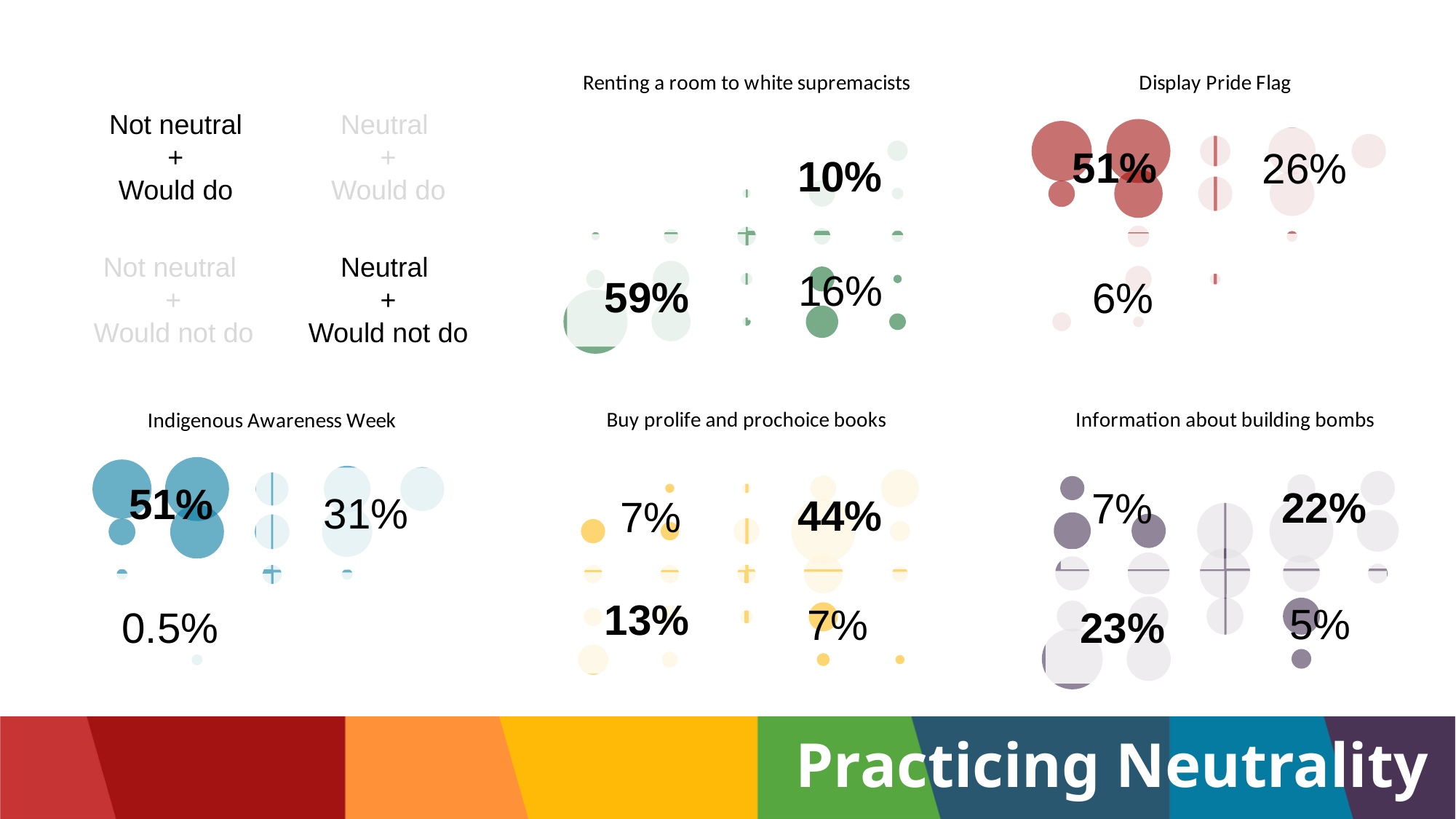
In the 'Display Pride Flag' chart, what is the difference between the 'Not neutral + Would do' and 'Neutral + Would do' percentages? 25% In the 'Buy prolife and prochoice books' chart, which quadrant has the highest percentage? Neutral + Would do In the 'Indigenous Awareness Week' chart, what percentage is shown for 'Not neutral + Would not do'? 0.5% In the 'Renting a room to white supremacists' chart, which is larger: 'Neutral + Would not do' or 'Neutral + Would do'? Neutral + Would not do How many bubble charts are shown on the slide? 5 In the 'Information about building bombs' chart, what is the difference between 'Not neutral + Would not do' and 'Neutral + Would do'? 1% In the 'Information about building bombs' chart, which quadrant has the lowest percentage? Neutral + Would not do In the 'Renting a room to white supremacists' chart, what percentage is shown for 'Neutral + Would do'? 10% What kind of chart is used to show the survey results on this slide? Bubble chart According to the legend, which quadrant position represents 'Neutral + Would not do'? Bottom right In the 'Display Pride Flag' chart, what percentage is shown for 'Not neutral + Would do'? 51% In the 'Renting a room to white supremacists' chart, what percentage is shown for 'Not neutral + Would not do'? 59%